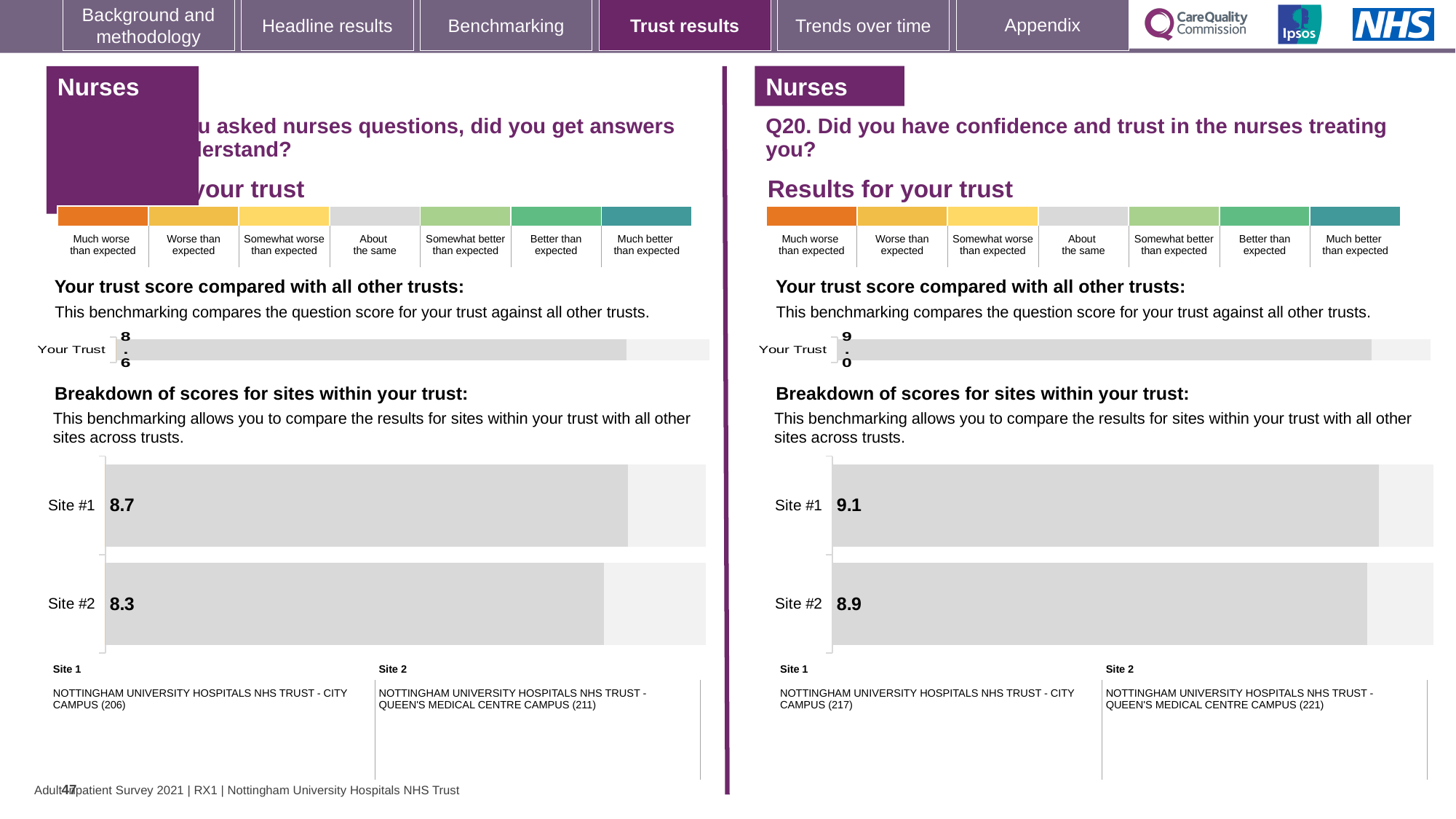
On the left-hand site breakdown chart, what is the difference between the Site #1 and Site #2 scores? 0.4 How many sites are shown in the right-hand site breakdown chart (Q20)? 2 What type of chart is used for the site breakdown on the left-hand side of the slide? Bar chart On the right-hand 'Your Trust' chart (Q20), what is the trust score shown? 9.0 On the left-hand site breakdown chart, what is the score for Site #2? 8.3 On the right-hand site breakdown chart (Q20), which site has the lower score? Site #2 On the right-hand chart (Q20), what is the score for Site #1? 9.1 On the left-hand 'Your Trust' chart, what is the trust score shown? 8.6 On the left-hand site breakdown chart, which site has the higher score? Site #1 On the left-hand site breakdown chart, what is the score for Site #1? 8.7 On the right-hand chart (Q20), what is the score for Site #2? 8.9 On the right-hand site breakdown chart (Q20), what is the difference between the Site #1 and Site #2 scores? 0.2